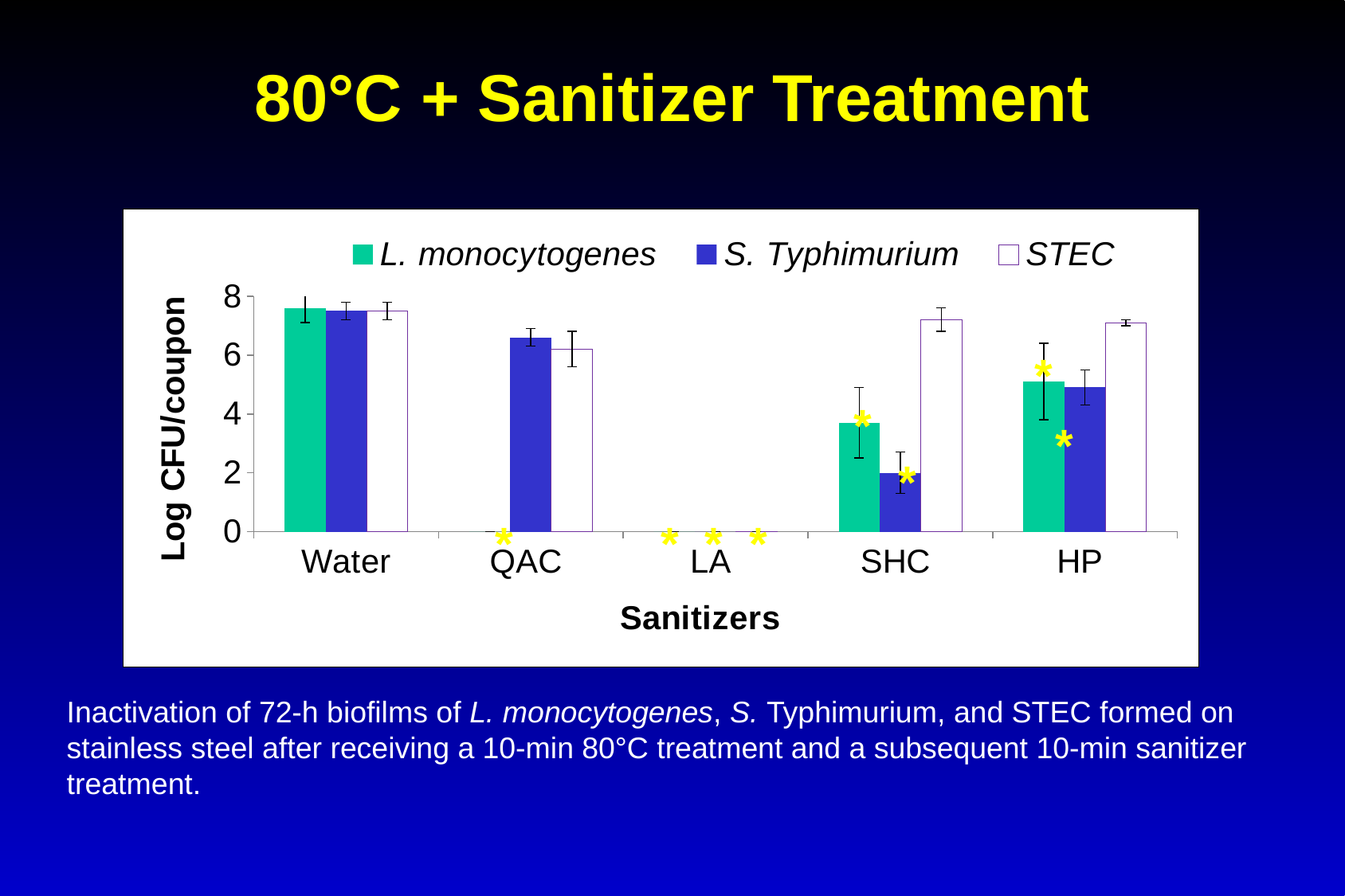
Is the value for STEC with SHC greater or less than 6? greater Is the value for L. monocytogenes with HP greater or less than 4? greater For QAC, which is larger: the S. Typhimurium bar or the L. monocytogenes bar? S. Typhimurium For which sanitizer are all three bars at 0? LA How many series does the legend list? 3 What is the title of the x axis? Sanitizers What is the title of the y axis? Log CFU/coupon Is the value for S. Typhimurium with SHC greater or less than 4? less For S. Typhimurium, which sanitizer has the highest value? Water What kind of chart is shown on the slide? bar chart For SHC, which is larger: the STEC bar or the L. monocytogenes bar? STEC How many sanitizer categories are shown on the x axis? 5